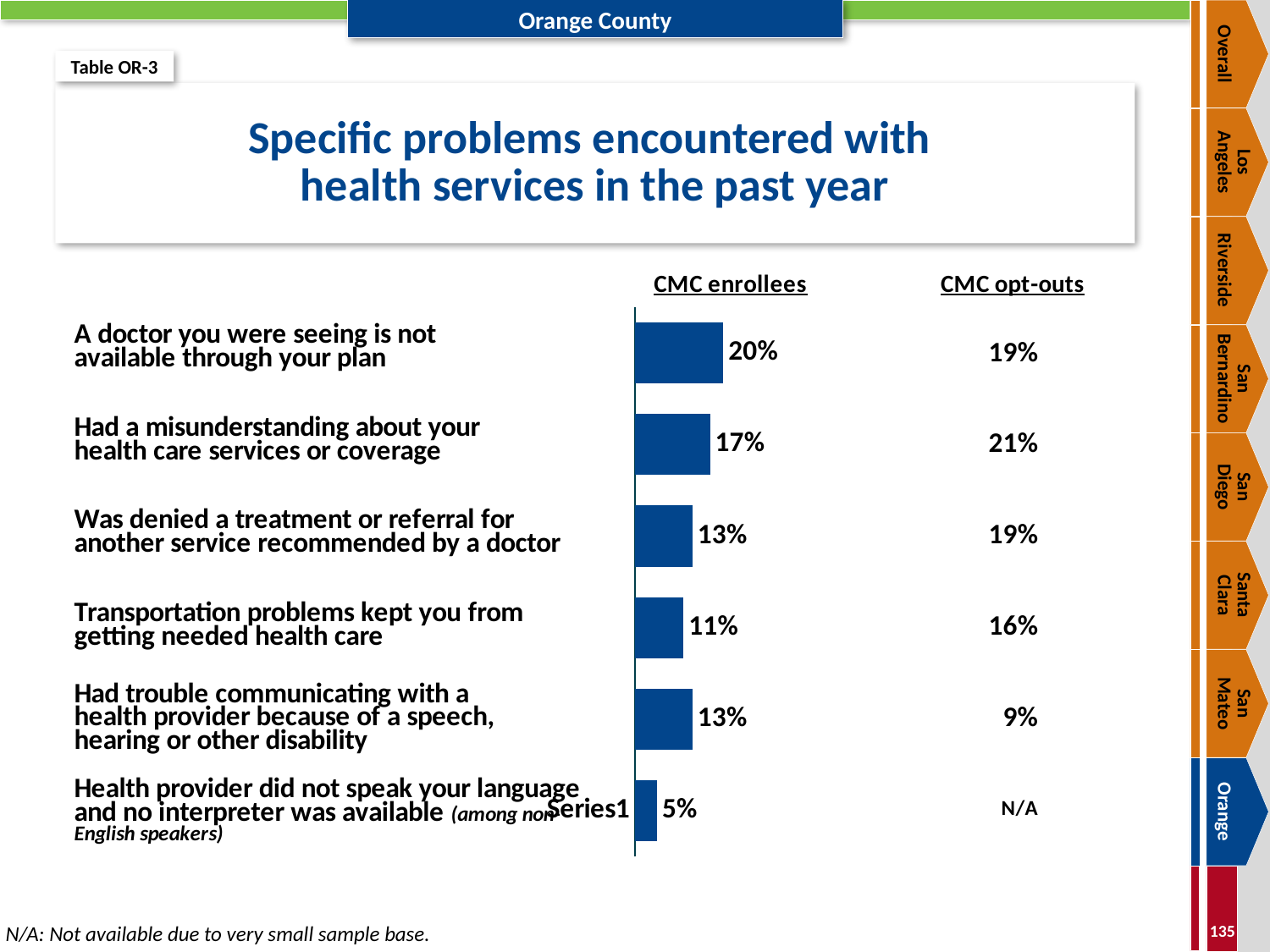
Which problem has the highest CMC enrollees value in the chart? A doctor you were seeing is not available through your plan Which has a larger CMC enrollees value: "Was denied a treatment or referral for another service recommended by a doctor" or "Transportation problems kept you from getting needed health care"? Was denied a treatment or referral for another service recommended by a doctor What is the title of the chart on the slide? Specific problems encountered with health services in the past year What kind of chart is shown on the slide? bar chart What is the difference between the CMC enrollees values for "A doctor you were seeing is not available through your plan" and "Had a misunderstanding about your health care services or coverage"? 3% Which problem has the lowest CMC enrollees value in the chart? Health provider did not speak your language and no interpreter was available What is the difference between the CMC enrollees values for "Had trouble communicating with a health provider because of a speech, hearing or other disability" and "Health provider did not speak your language and no interpreter was available"? 8% How many bars does the chart show? 6 What is the CMC enrollees value for "Transportation problems kept you from getting needed health care"? 11% What is the CMC enrollees value for "Health provider did not speak your language and no interpreter was available"? 5% What is the CMC enrollees value for "A doctor you were seeing is not available through your plan"? 20% What is the CMC enrollees value for "Had a misunderstanding about your health care services or coverage"? 17%